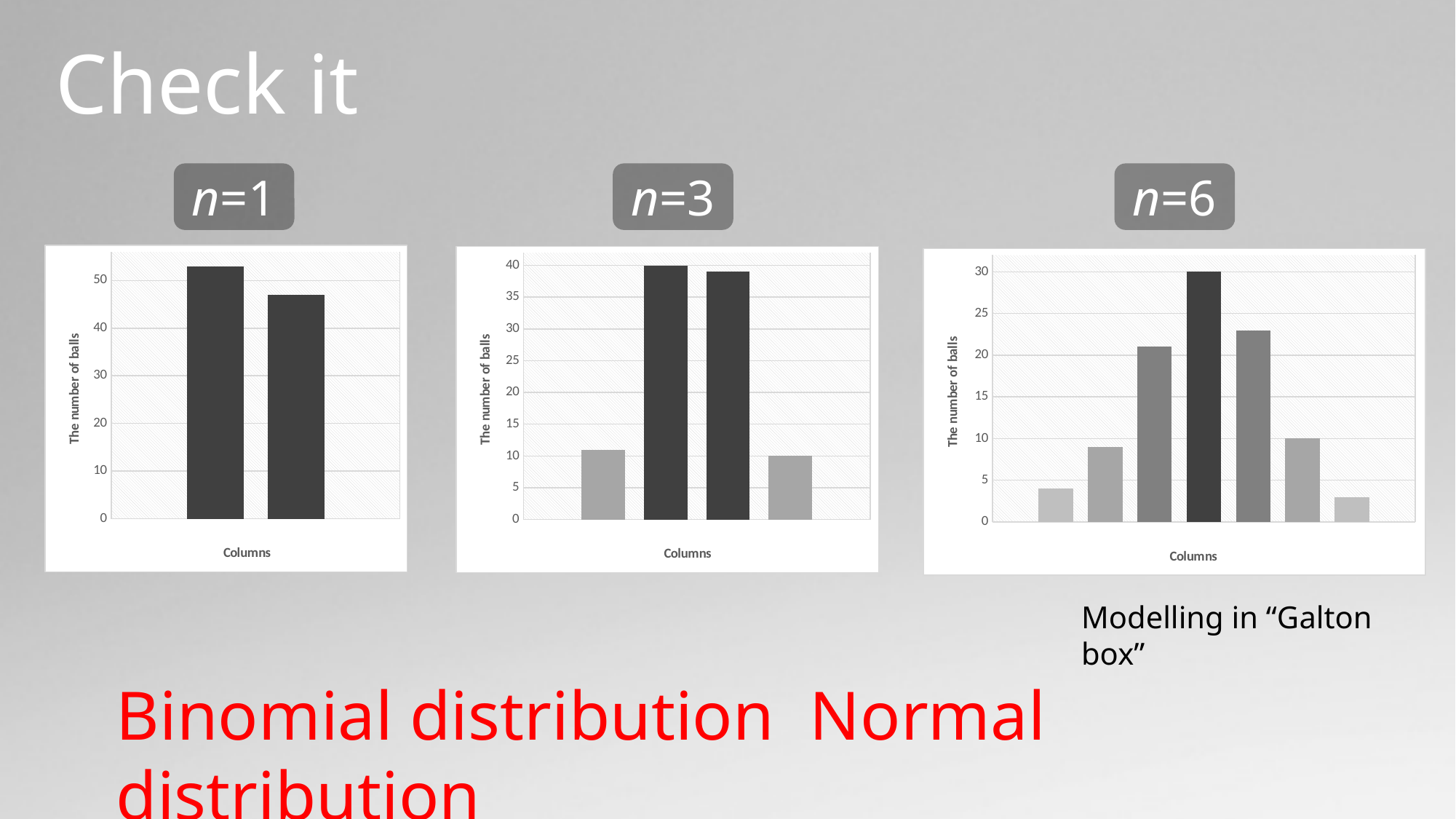
In the n=3 chart, what value does the tallest bar reach? 40 In the n=1 chart, is the value of the left bar greater or less than 50? greater How many bars are plotted in the n=1 chart? 2 How many bars are plotted in the n=6 chart? 7 In the n=1 chart, which bar is taller, the left one or the right one? the left one In the n=6 chart, what value does the tallest bar reach? 30 What kind of chart is shown under the n=1 label? bar chart In the n=6 chart, which bar is the tallest? the middle (fourth) bar How many bars are plotted in the n=3 chart? 4 In the n=3 chart, is the value of the leftmost bar greater or less than 15? less In the n=1 chart, is the value of the right bar greater or less than 50? less What is the title of the vertical axis in the n=6 chart? The number of balls